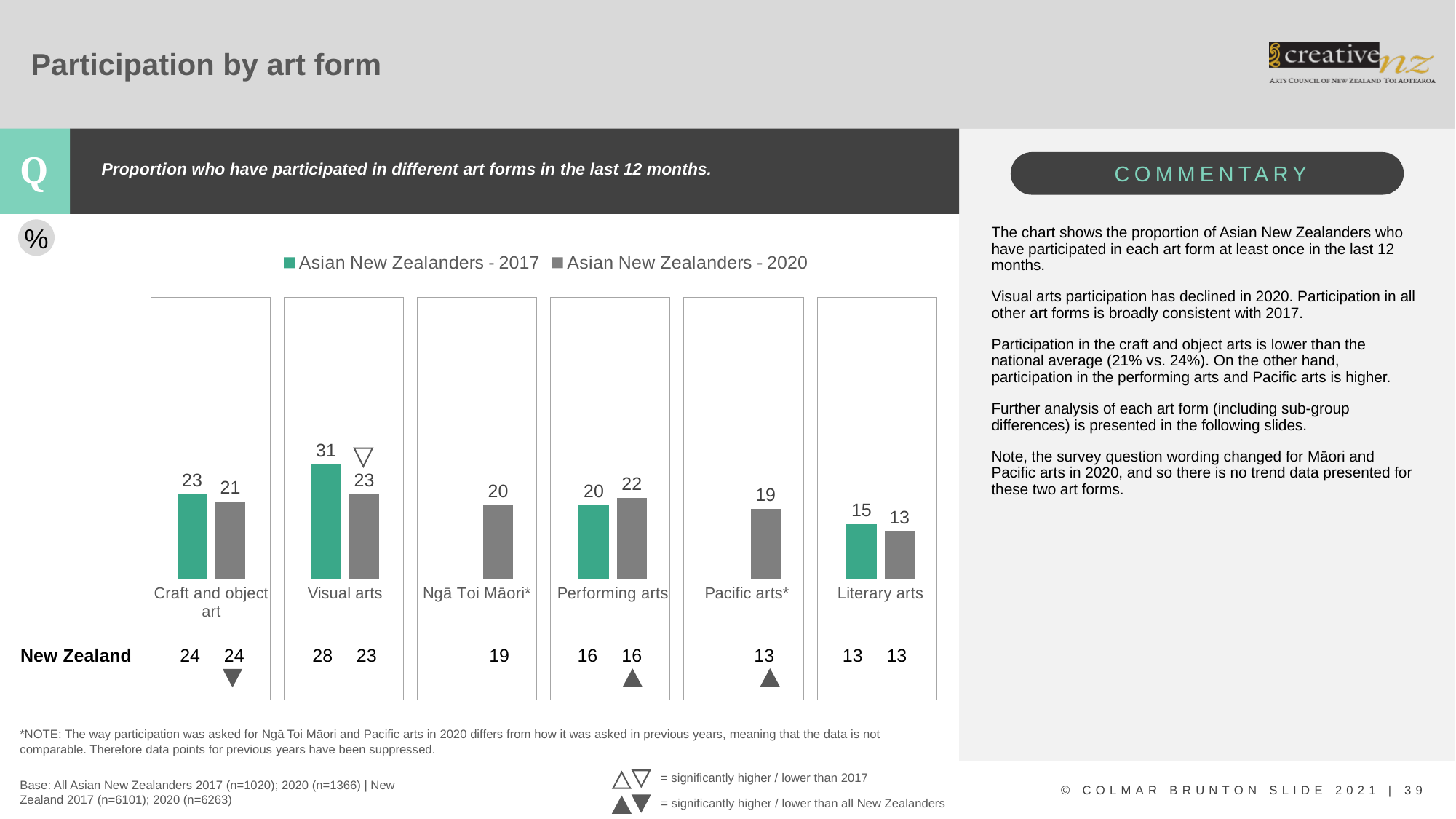
For Performing arts, which is larger: the Asian New Zealanders - 2017 value or the Asian New Zealanders - 2020 value? Asian New Zealanders - 2020 What type of chart is shown on the slide? Bar chart What is the value for Asian New Zealanders - 2020 for Ngā Toi Māori*? 20 How many art form categories are shown on the x axis of the chart? 6 How many series does the chart legend list? 2 What is the difference between the 2017 and 2020 values for Visual arts? 8 What is the value for Asian New Zealanders - 2017 for Visual arts? 31 What is the value for Asian New Zealanders - 2017 for Literary arts? 15 Which colour represents Asian New Zealanders - 2020 in the chart? Grey What is the value for Asian New Zealanders - 2020 for Performing arts? 22 Which art form has the highest value for Asian New Zealanders - 2017? Visual arts Which art form has the lowest value for Asian New Zealanders - 2020? Literary arts